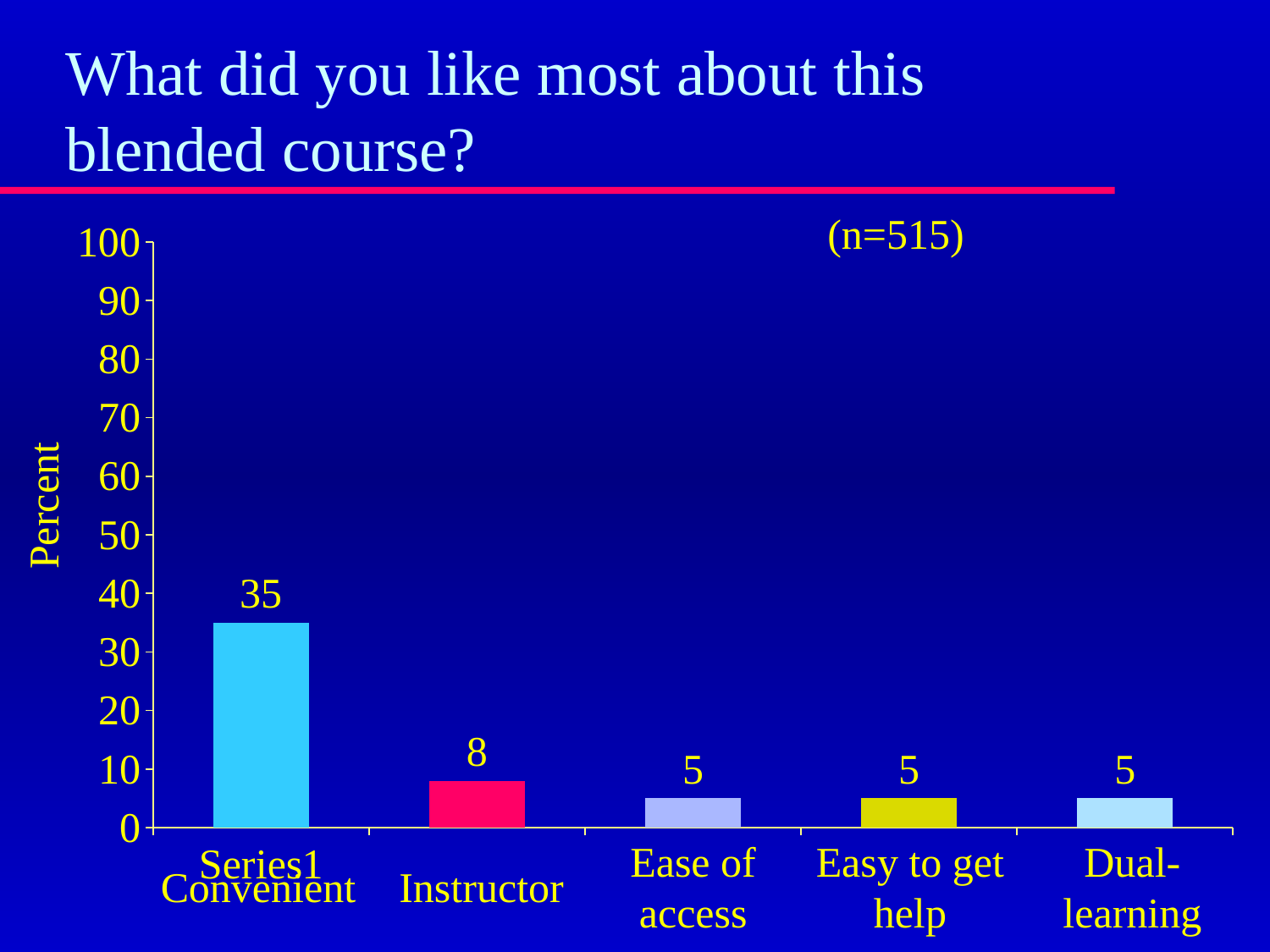
What is the label of the y axis? Percent What kind of chart is shown on the slide? bar chart What is the value for Ease of access? 5 Is the value for Convenient greater or less than 30? greater What is the value for Convenient? 35 What is the difference between the values for Convenient and Instructor? 27 What is the value for Instructor? 8 How many categories are shown on the x axis? 5 What sample size (n) is shown on the slide? (n=515) Which category has the highest value? Convenient Which is larger, the value for Instructor or the value for Easy to get help? Instructor What is the value for Dual-learning? 5